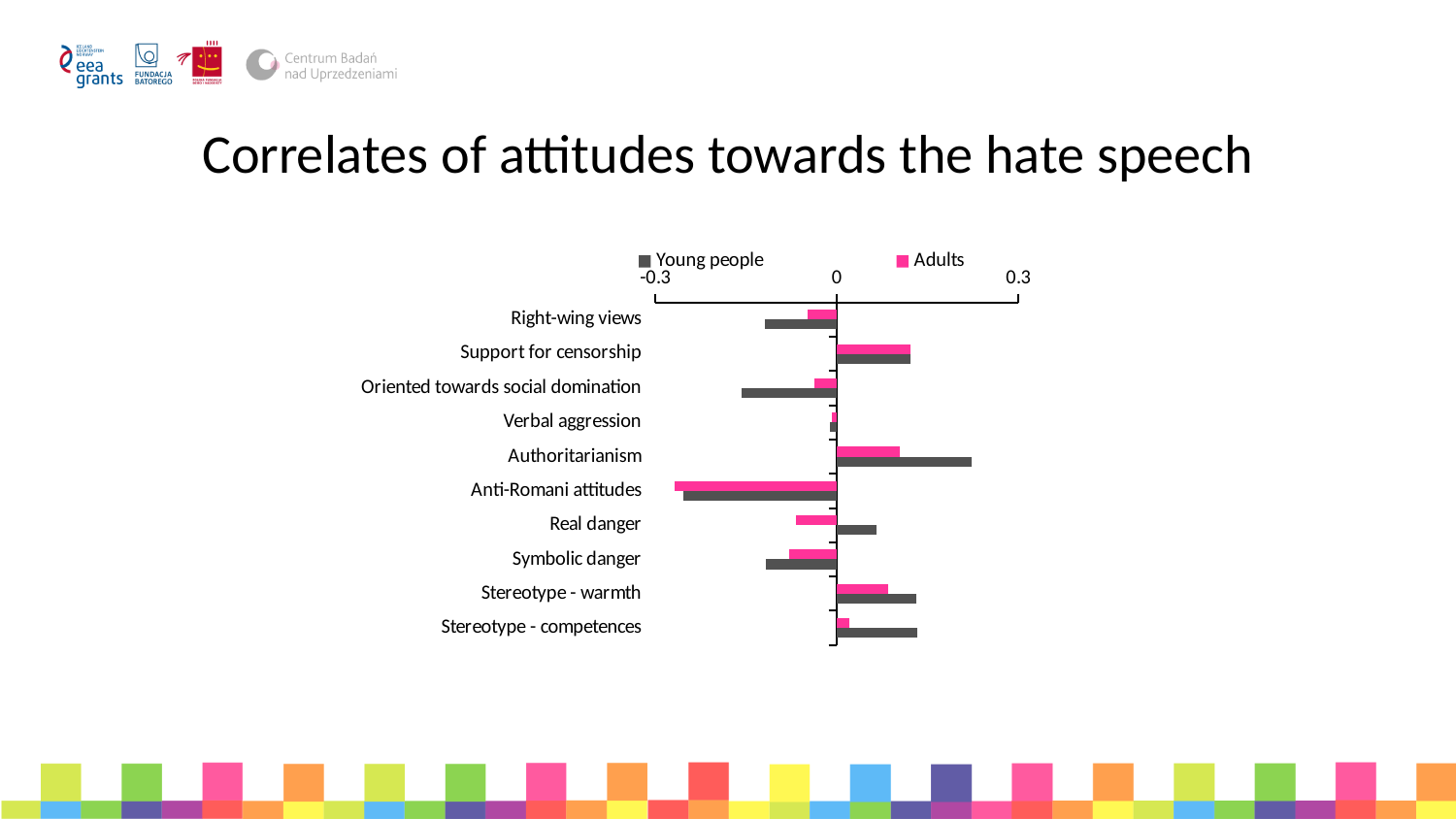
Which category has the lowest value for Young people? Anti-Romani attitudes For Authoritarianism, which series has the larger value, Young people or Adults? Young people For Stereotype - competences, which series has the larger value, Young people or Adults? Young people Is the value for Young people for Oriented towards social domination greater or less than 0? less What kind of chart is shown on the slide? Bar chart How many categories are plotted on the chart? 10 Which category has the lowest value for Adults? Anti-Romani attitudes How many series does the legend list? 2 Which category has the highest value for Young people? Authoritarianism What colour represents the Adults series in the chart? Pink Is the value for Young people for Authoritarianism greater or less than 0? greater Is the value for Adults for Real danger greater or less than 0? less